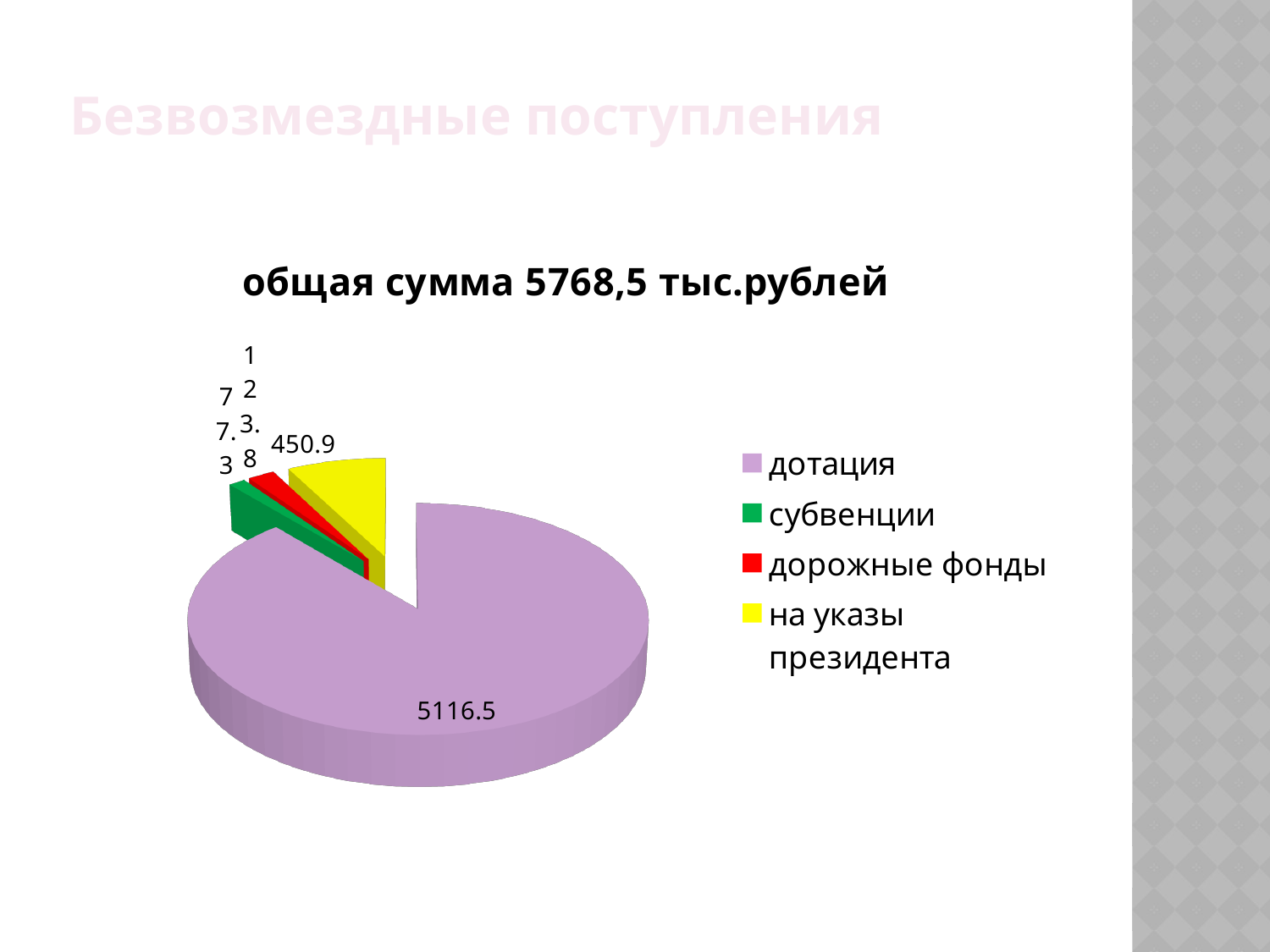
What is the value shown for дотация? 5116.5 What is the difference between the values for дотация and на указы президента? 4665.6 How many slices does the pie chart have? 4 Which category has the largest slice of the pie? дотация Which is larger, дотация or на указы президента? дотация What is the value shown for на указы президента? 450.9 What is the title of the chart? общая сумма 5768,5 тыс.рублей What kind of chart is shown on the slide? pie chart Which is larger, на указы президента or субвенции? на указы президента What colour is the slice for дотация? purple How many entries does the legend list? 4